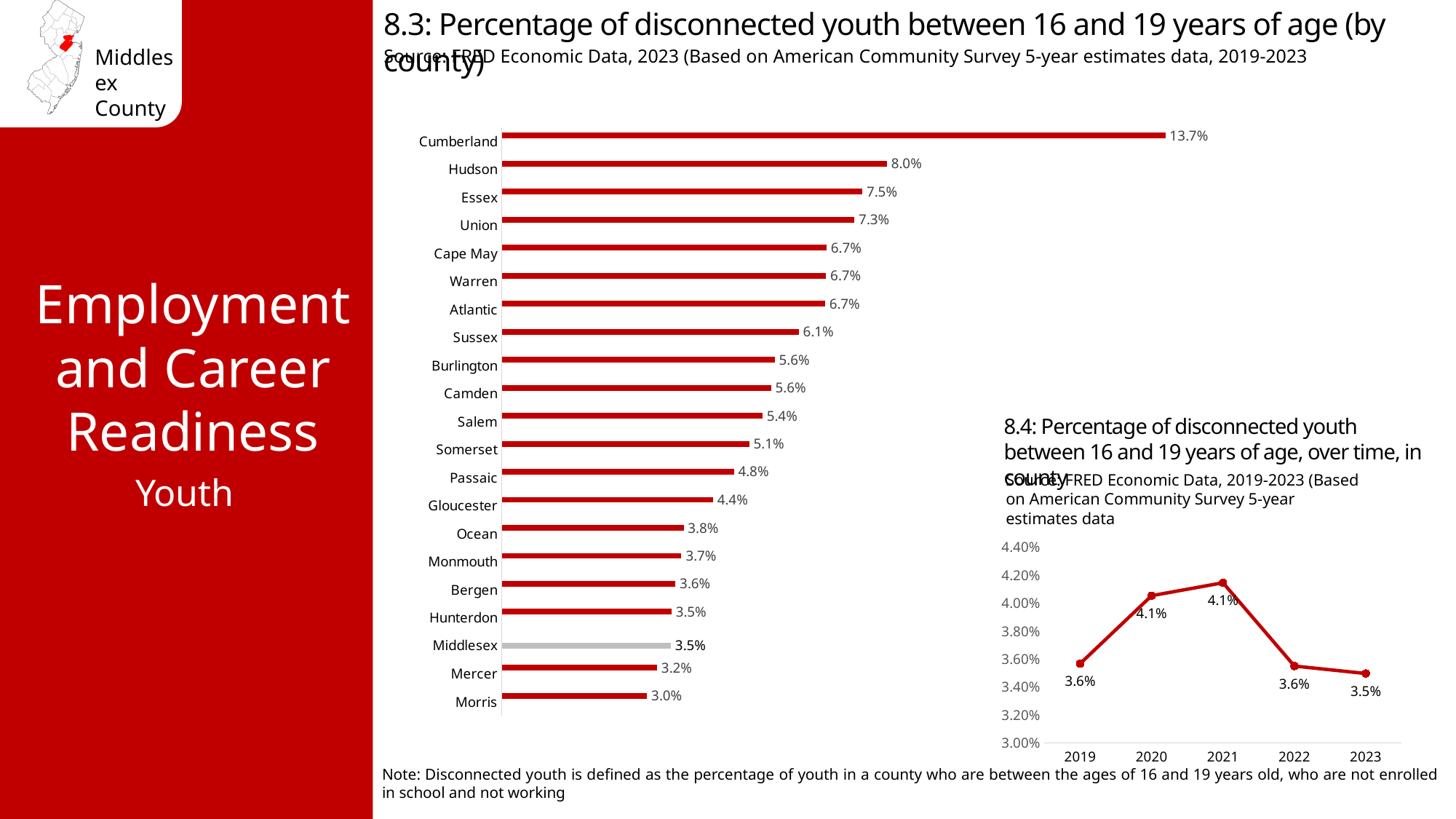
In chart 8.3 (by county), how many counties are shown? 21 In chart 8.3 (percentage of disconnected youth by county), what is the value for Middlesex? 3.5% In chart 8.3 (by county), what is the value for Somerset? 5.1% In chart 8.3 (by county), which has a higher value, Essex or Passaic? Essex In chart 8.4 (disconnected youth over time), how many years are plotted? 5 In chart 8.3 (by county), what is the difference between the values for Cumberland and Hudson? 5.7% In chart 8.4 (disconnected youth over time), what is the difference between the values for 2020 and 2023? 0.6% What kind of chart is chart 8.3 (percentage of disconnected youth by county)? Bar chart In chart 8.3 (by county), which county has the highest percentage of disconnected youth? Cumberland In chart 8.3 (by county), which bar is shown in a different colour (grey) from the others? Middlesex In chart 8.4 (disconnected youth over time), what is the value for 2021? 4.1% In chart 8.3 (by county), which county has the lowest percentage of disconnected youth? Morris